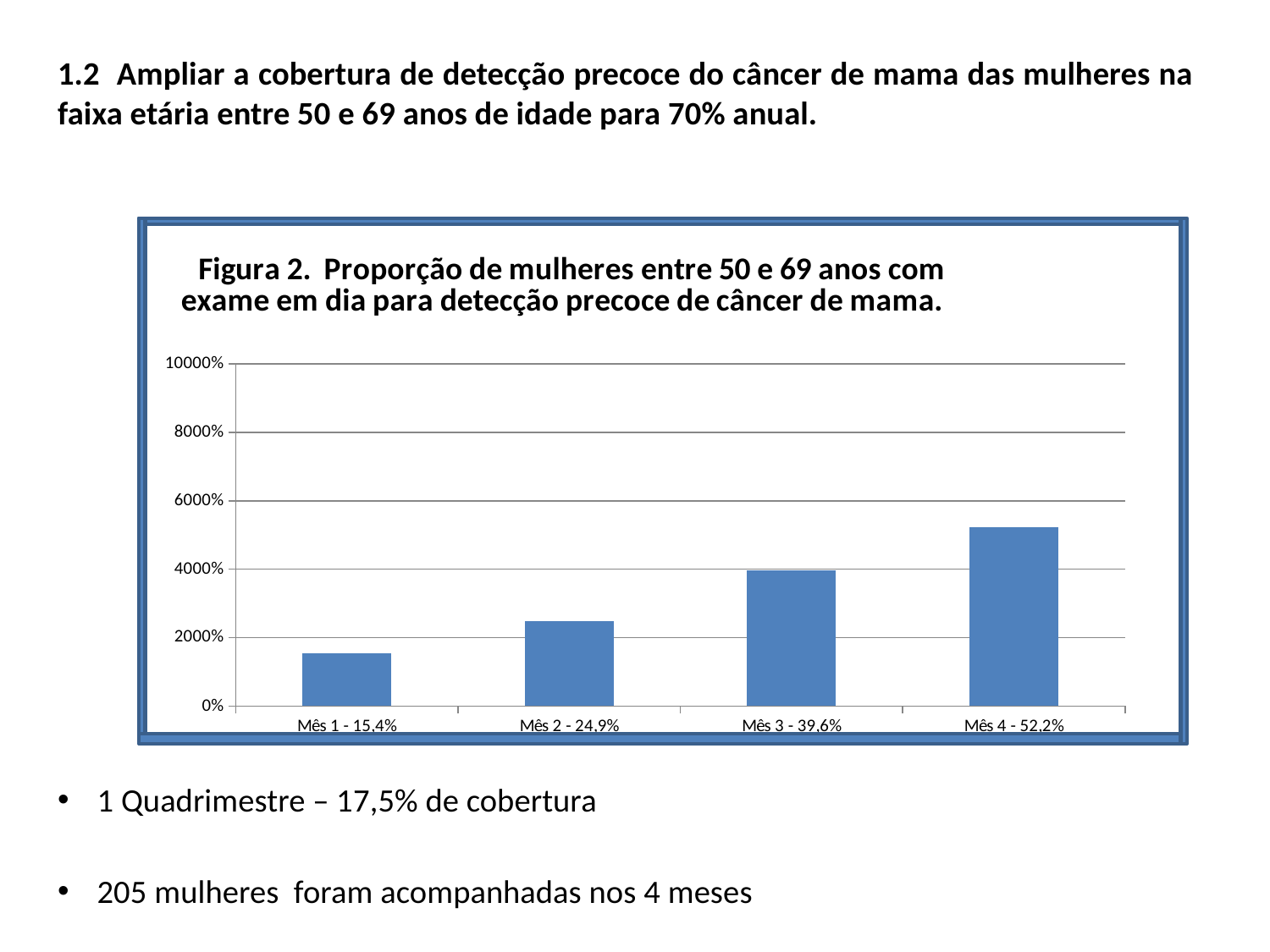
Is the bar for Mês 1 greater or less than 2000% on the y axis? less What percentage is shown in the category label for Mês 4? 52,2% Which month has the shortest bar in the chart? Mês 1 Do the bar values rise or fall from Mês 1 to Mês 4? rise What kind of chart is shown in Figura 2? bar chart What percentage is shown in the category label for Mês 1? 15,4% Is the bar for Mês 4 greater or less than 4000% on the y axis? greater What percentage is shown in the category label for Mês 3? 39,6% Which month has the tallest bar in the chart? Mês 4 What percentage is shown in the category label for Mês 2? 24,9% How many bars (months) are plotted in the chart? 4 What is the difference between the percentages in the labels for Mês 4 and Mês 1? 36,8%